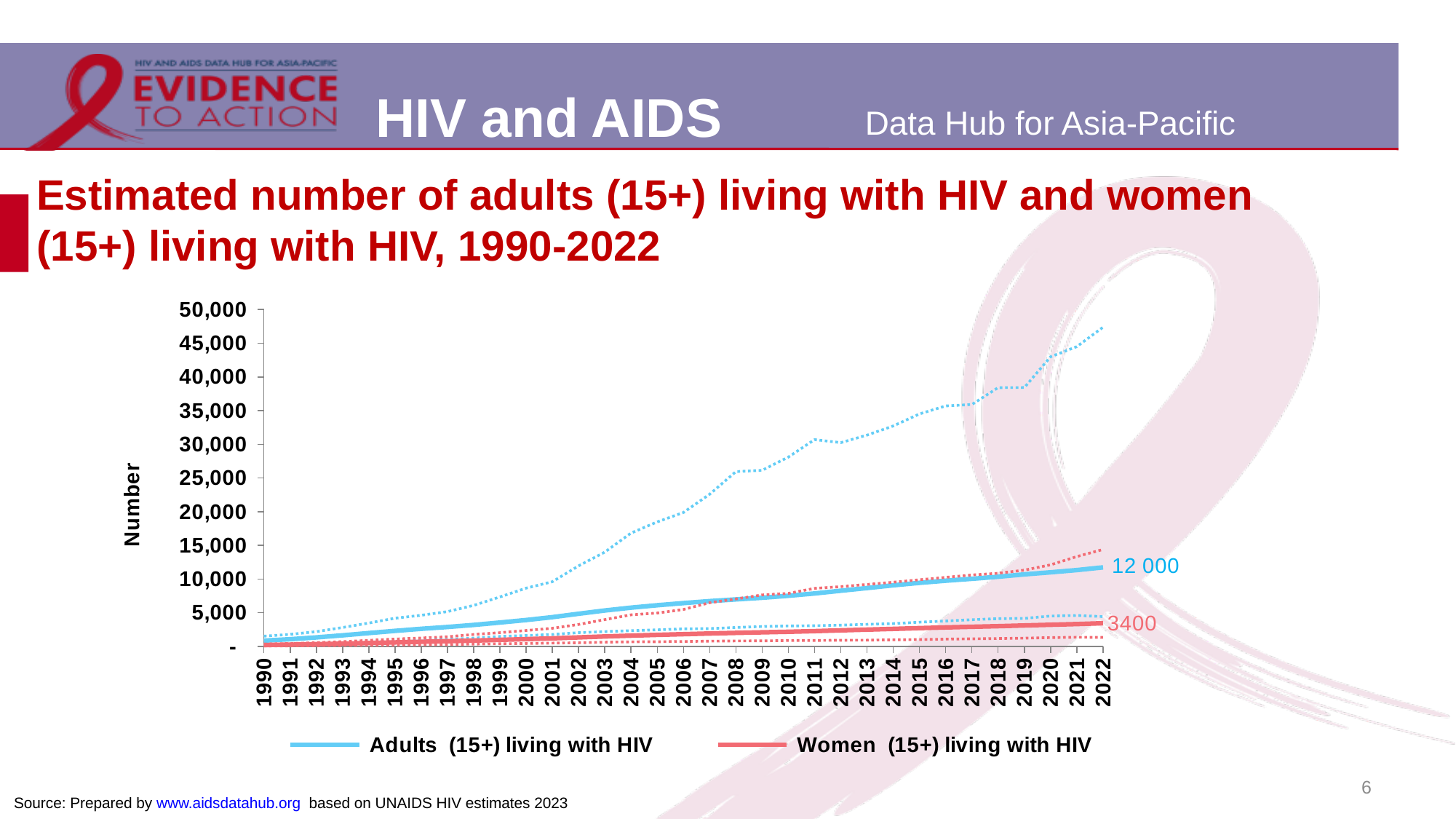
Is the value for women (15+) living with HIV in 2000 greater or less than 5,000? less Is the value for adults (15+) living with HIV in 2022 greater or less than 10,000? greater What kind of chart is shown on the slide? line chart In which year is the number of adults (15+) living with HIV highest? 2022 How many series does the legend list? 2 What is the estimated number of women (15+) living with HIV in 2022? 3400 How many years are shown on the x axis? 33 Is the value for adults (15+) living with HIV in 2010 greater or less than 10,000? less What is the estimated number of adults (15+) living with HIV in 2022? 12 000 Does the number of adults (15+) living with HIV rise or fall from 1990 to 2022? rises Which series has the higher value in 2022, adults (15+) living with HIV or women (15+) living with HIV? Adults (15+) living with HIV What is the label on the y axis? Number